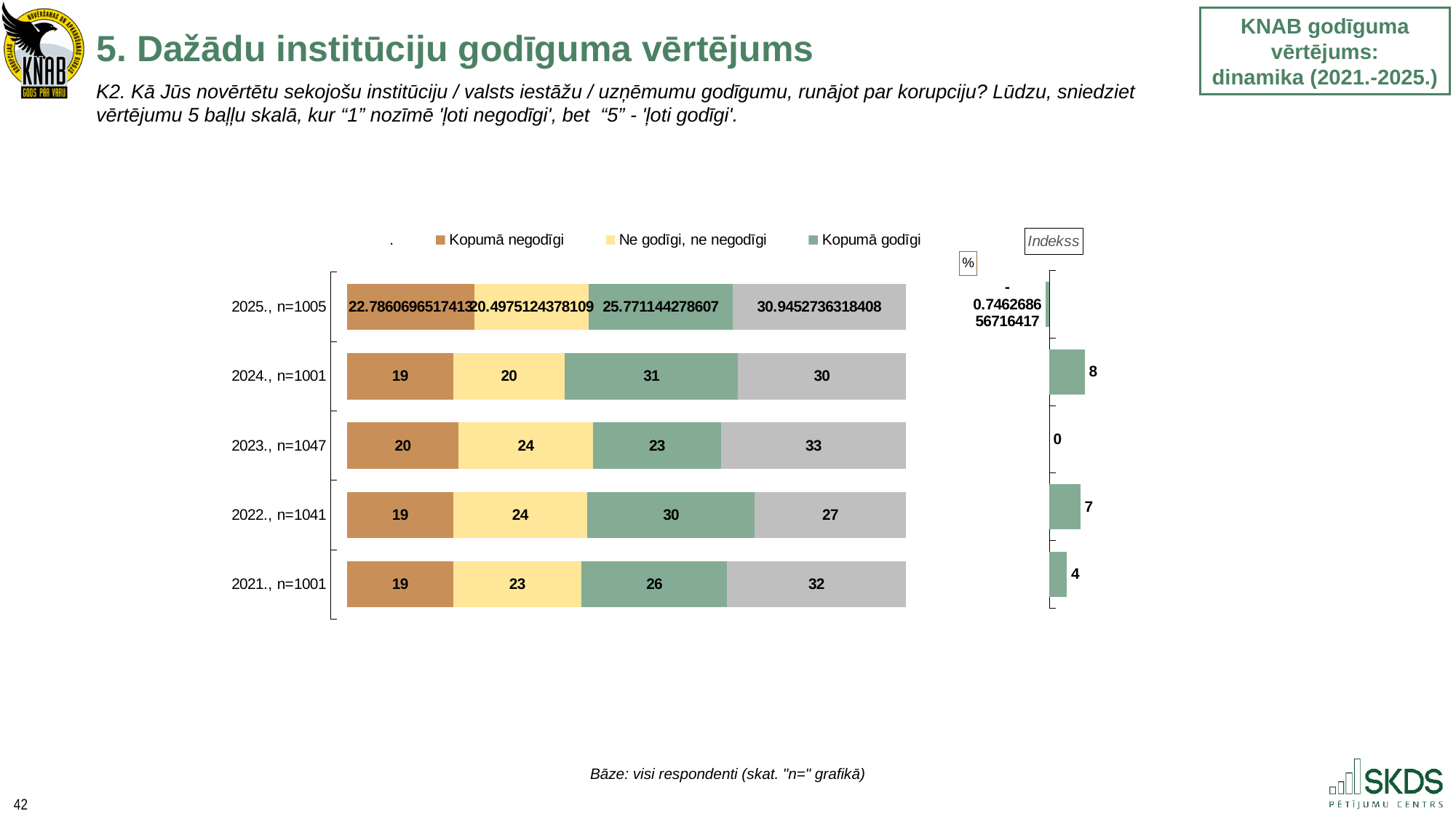
In the left stacked bar chart, what is the total of all segments for 2024., n=1001? 100 In the 'Indekss' chart on the right, which year has the highest index value? 2024., n=1001 In the left stacked bar chart, what is the value of 'Kopumā negodīgi' for 2023., n=1047? 20 In the left stacked bar chart, what is the difference between the 'Kopumā godīgi' values for 2024., n=1001 and 2023., n=1047? 8 What kind of chart is the main chart on the left of the slide? bar chart How many series does the legend of the left stacked bar chart list? 3 In the left stacked bar chart, what is the value of 'Ne godīgi, ne negodīgi' for 2021., n=1001? 23 In the left stacked bar chart, what is the value of 'Kopumā godīgi' for 2024., n=1001? 31 In the 'Indekss' chart on the right, what is the value for 2024., n=1001? 8 How many year categories are shown in the left stacked bar chart? 5 In the left stacked bar chart, which year has the highest 'Kopumā godīgi' value? 2024., n=1001 In the left stacked bar chart, which year has the larger 'Kopumā godīgi' value, 2022., n=1041 or 2021., n=1001? 2022., n=1041